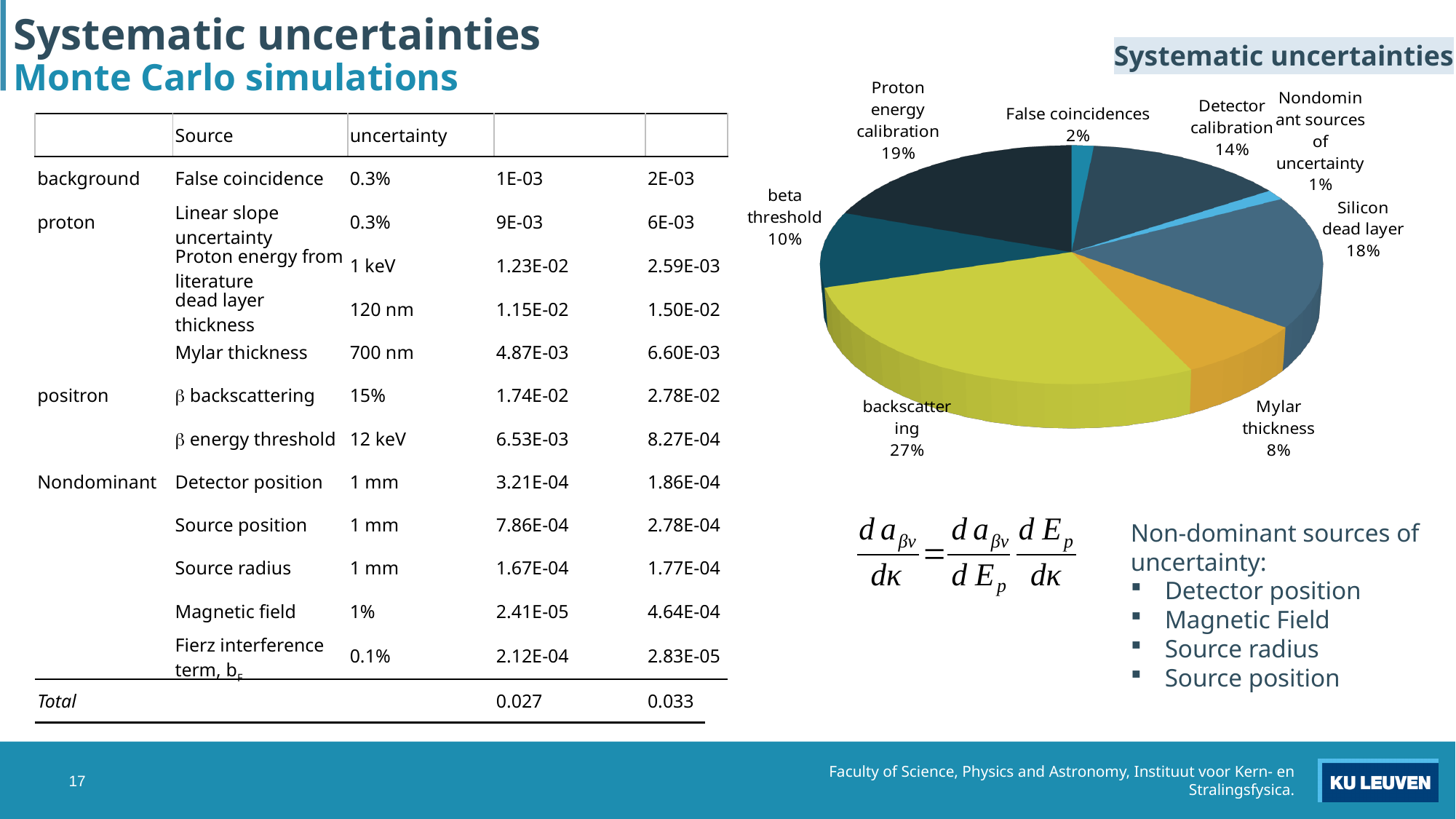
How many slices does the pie chart have? 8 Which slice of the pie is the smallest? Nondominant sources of uncertainty What share of the pie does Detector calibration account for? 14% Which slice of the pie is the largest? backscattering What share of the pie does backscattering account for? 27% Which is larger, the share for beta threshold or the share for Mylar thickness? beta threshold What is the difference in percentage points between the backscattering share and the Silicon dead layer share? 9 What share of the pie does Silicon dead layer account for? 18% What is the title of the chart? Systematic uncertainties What type of chart is shown on the slide? pie chart